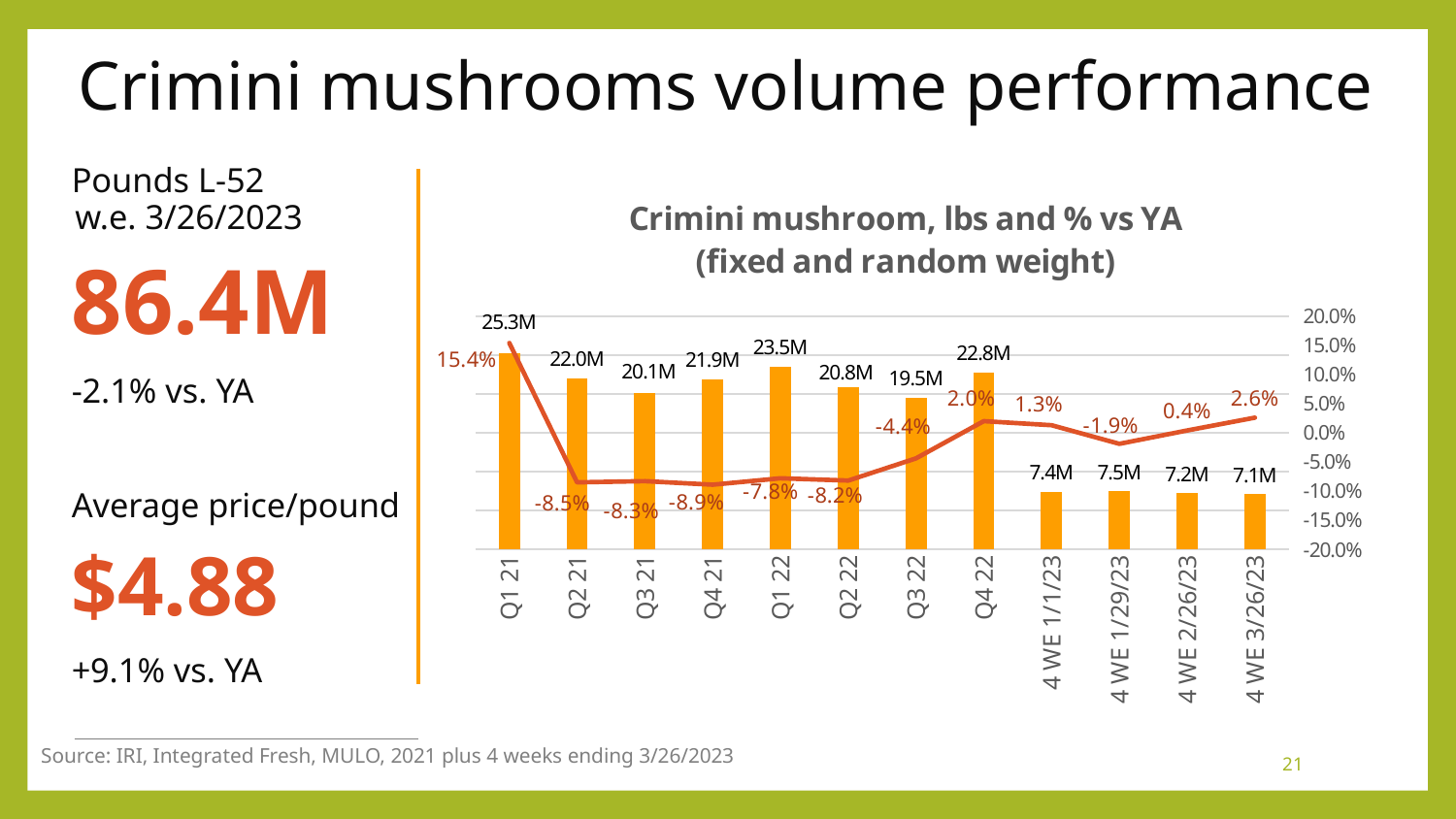
What is the volume in pounds for the 4 WE 3/26/23 period? 7.1M What is the % vs YA value for Q3 22? -4.4% What is the difference in pounds between Q4 22 and Q3 22? 3.3M Which is larger, the volume for Q1 22 or Q4 22? Q1 22 How many periods are shown on the x axis? 12 What is the volume in pounds for Q1 21? 25.3M Does the % vs YA line rise or fall from Q2 22 to Q4 22? Rise What is the % vs YA value for the 4 WE 1/29/23 period? -1.9% Which period has the lowest % vs YA value? Q4 21 Which period has the highest volume in pounds? Q1 21 What is the title of the chart? Crimini mushroom, lbs and % vs YA (fixed and random weight) What kind of chart is this? Combination bar and line chart